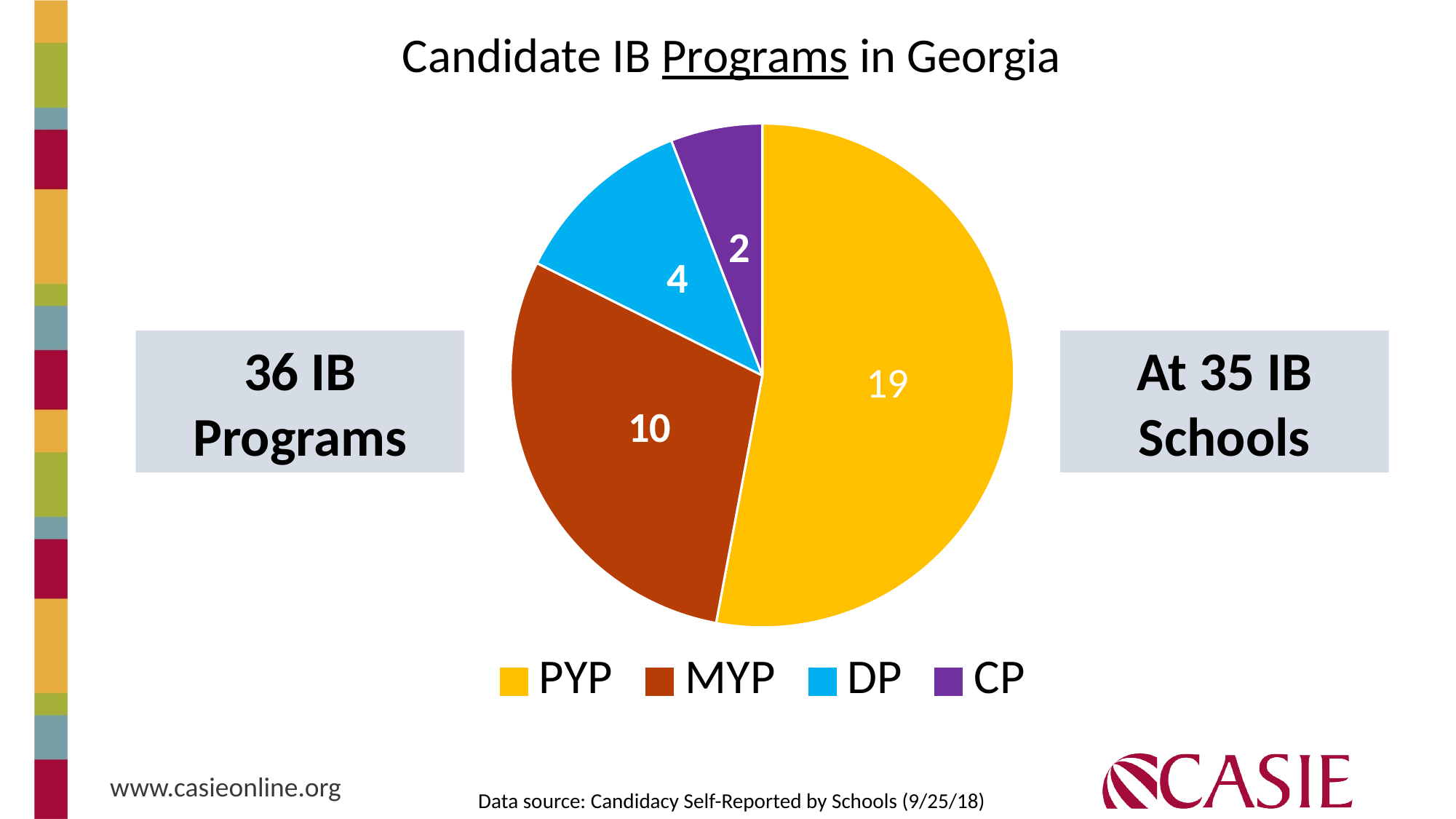
How many candidate PYP programs does the pie chart show? 19 Which has more candidate programs, DP or CP? DP How many candidate CP programs does the pie chart show? 2 What is the difference between the number of PYP programs and MYP programs? 9 Which program has the smallest slice of the pie chart? CP How many entries does the legend list? 4 How many slices does the pie chart have? 4 What type of chart is shown on the slide? pie chart What colour is the MYP slice in the pie chart? dark orange Which program has the largest slice of the pie chart? PYP How many candidate MYP programs does the pie chart show? 10 How many candidate DP programs does the pie chart show? 4